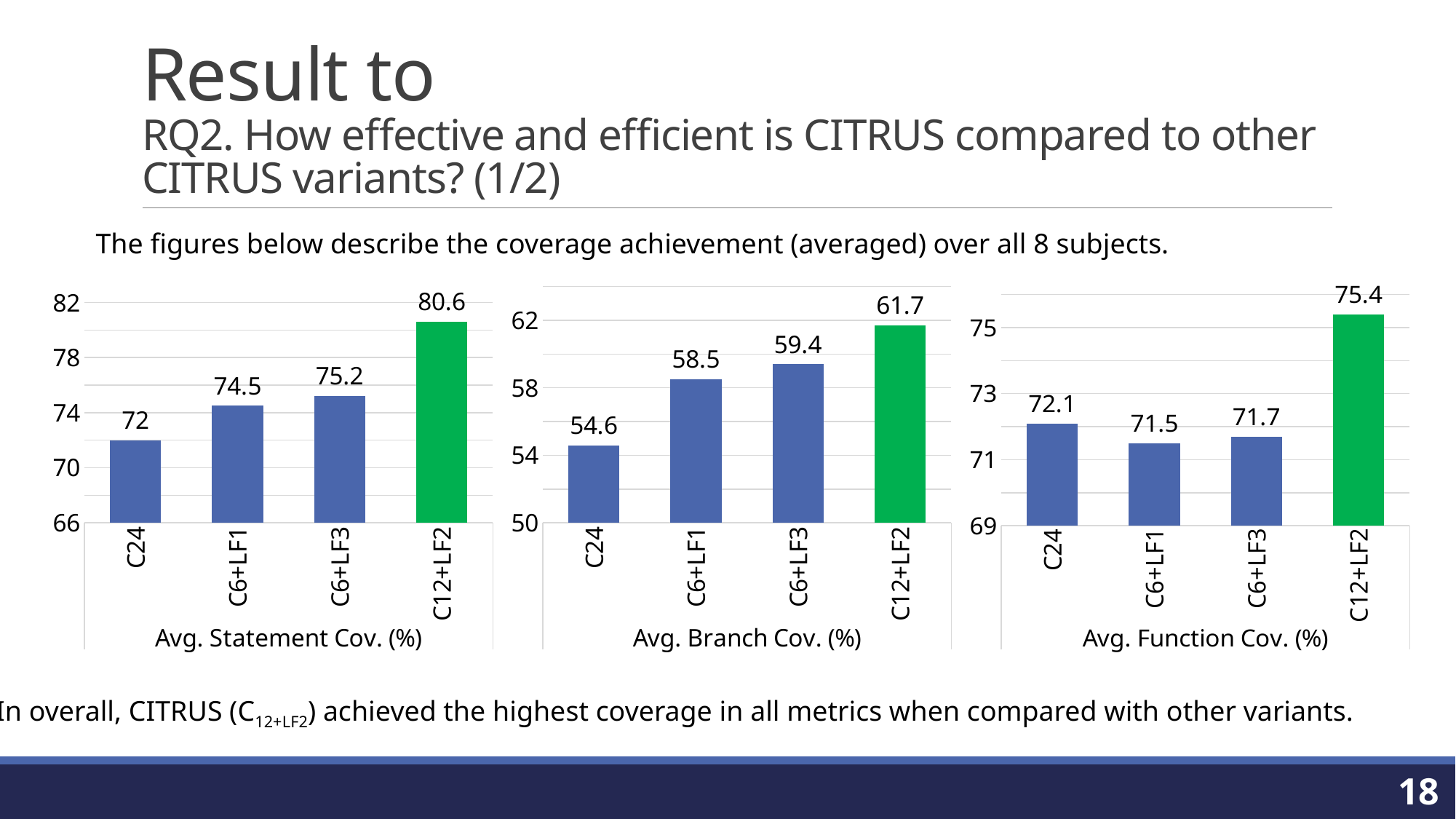
In the Avg. Function Cov. (%) chart, what colour is the bar for C12+LF2? green In the Avg. Function Cov. (%) chart, what is the value for C6+LF3? 71.7 In the Avg. Branch Cov. (%) chart, is the value for C6+LF1 greater or less than 58? greater In the Avg. Function Cov. (%) chart, which category has the lowest value? C6+LF1 How many categories are shown in the Avg. Branch Cov. (%) chart? 4 In the Avg. Branch Cov. (%) chart, what is the value for C24? 54.6 In the Avg. Statement Cov. (%) chart, what is the value for C6+LF1? 74.5 In the Avg. Statement Cov. (%) chart, which category has the highest value? C12+LF2 In the Avg. Statement Cov. (%) chart, what is the difference between C12+LF2 and C6+LF3? 5.4 In the Avg. Function Cov. (%) chart, which is larger, C24 or C6+LF1? C24 What kind of chart is the Avg. Statement Cov. (%) chart? bar chart In the Avg. Branch Cov. (%) chart, what is the difference between C12+LF2 and C24? 7.1